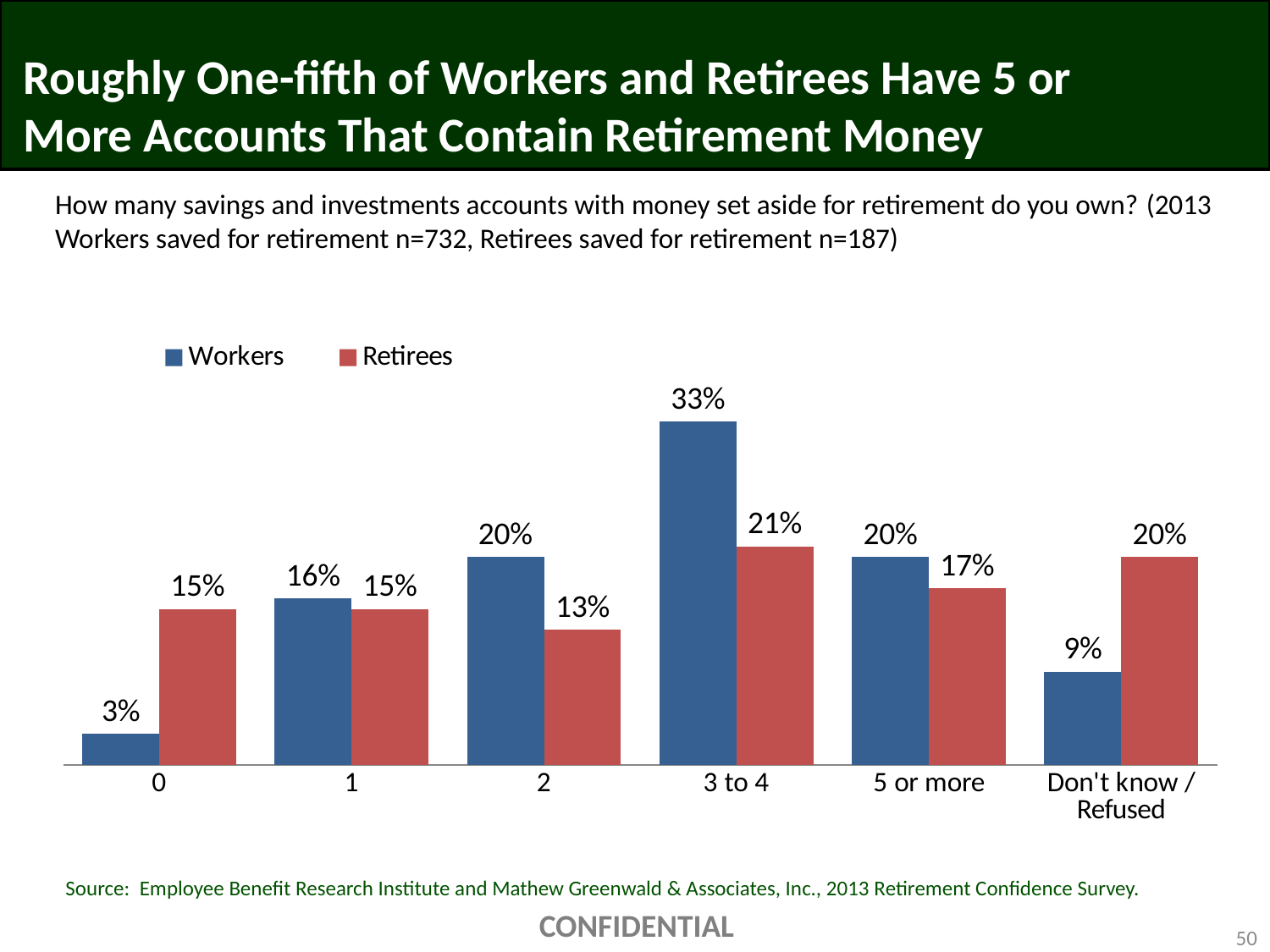
What percentage of Retirees answered Don't know / Refused? 20% Which category has the lowest value for Retirees? 2 For the 5 or more category, which is larger, Workers or Retirees? Workers How many series does the legend list? 2 Which category has the highest value for Workers? 3 to 4 What percentage of Retirees own 0 accounts? 15% What percentage of Workers own 3 to 4 accounts? 33% How many categories are shown on the x axis? 6 Which category has the lowest value for Workers? 0 What is the difference between Workers and Retirees for the 3 to 4 category? 12% Which colour represents Retirees in the chart? Red What kind of chart is shown on the slide? Bar chart